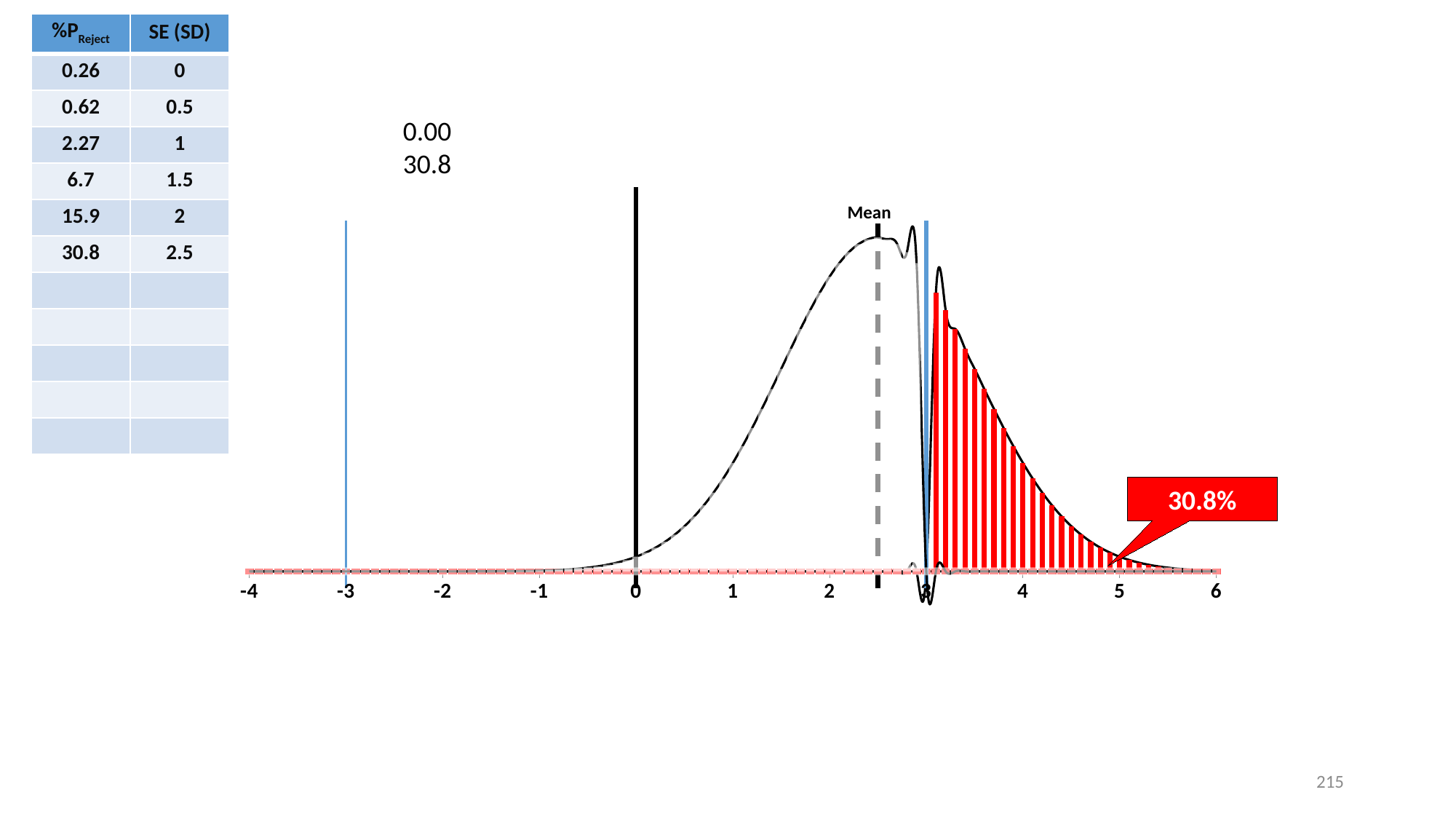
Is the dashed Mean line positioned at an x value greater or less than 3? less At which x-axis value does the red shaded region begin? 3 What kind of chart is shown on the slide? line chart Is the dashed Mean line positioned at an x value greater or less than 2? greater At which x-axis value is the thick black vertical line drawn? 0 What label is attached to the dashed vertical line on the chart? Mean What is the lowest value shown on the x axis of the chart? -4 What is the highest value shown on the x axis of the chart? 6 Does the curve rise or fall as x increases from 3 to 6? fall Does the curve rise or fall as x increases from 0 to 2? rise What percentage is shown in the red callout on the chart? 30.8% How many tick labels are shown on the x axis of the chart? 11